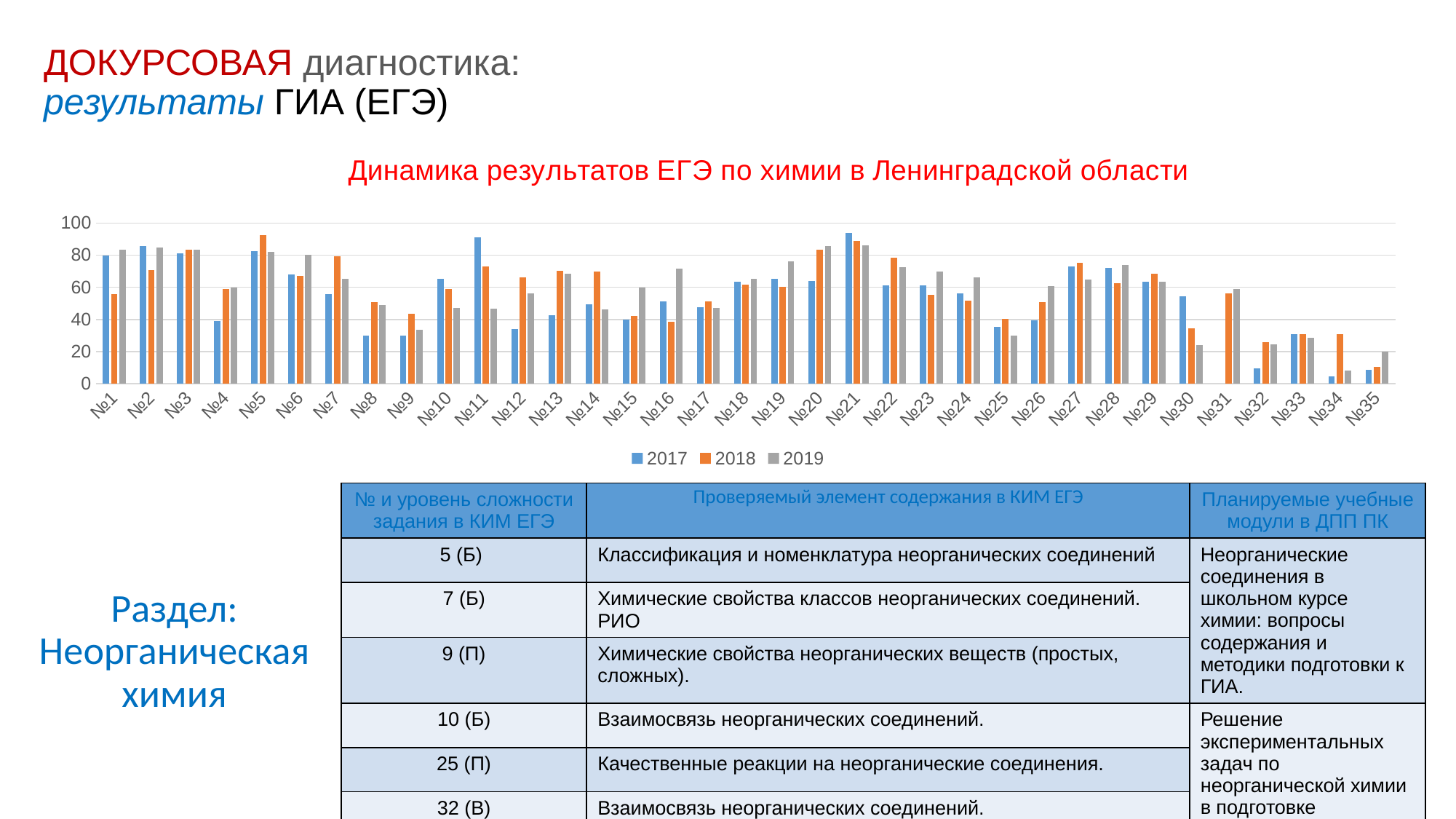
Is the 2019 value for №16 greater or less than 60? greater What is the title of the chart? Динамика результатов ЕГЭ по химии в Ленинградской области Is the 2018 value for №5 greater or less than 80? greater Which years are listed in the chart legend? 2017, 2018, 2019 For №12, which year has the larger value, 2017 or 2018? 2018 What kind of chart is shown on the slide? bar chart How many series does the legend of the chart list? 3 Is the 2019 value for №30 greater or less than 40? less How many task categories (№1, №2, ...) are shown along the x axis of the chart? 35 For №11, which year has the larger value, 2017 or 2019? 2017